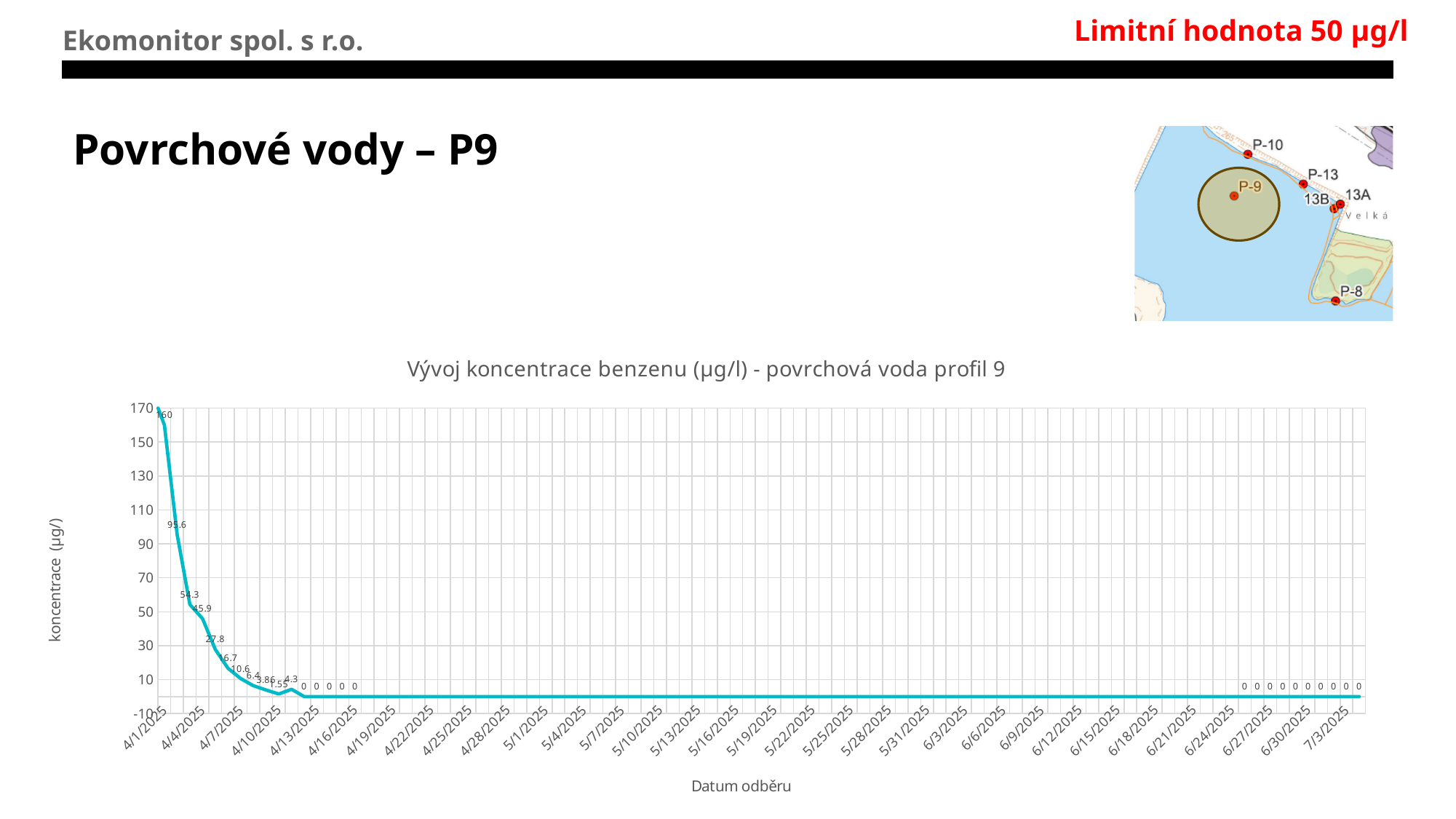
What is the benzene concentration value plotted for 4/1/2025? 160 Is the value plotted for 4/1/2025 greater or less than 150? greater What is the label of the vertical axis of the chart? koncentrace (µg/l) How many data series (lines) are plotted on the chart? 1 Which is larger, the second plotted value (95.6) or the third plotted value (54.3)? 95.6 What is the difference between the highest plotted value (160) and the second plotted value (95.6)? 64.4 What is the highest benzene concentration value plotted on the chart? 160 What is the title of the chart? Vývoj koncentrace benzenu (µg/l) - povrchová voda profil 9 What is the lowest benzene concentration value plotted on the chart? 0 Is the value plotted for 7/3/2025 greater or less than 10? less What kind of chart is shown on the slide? line chart Do the plotted benzene concentration values rise or fall from 4/1/2025 onward along the x axis? fall